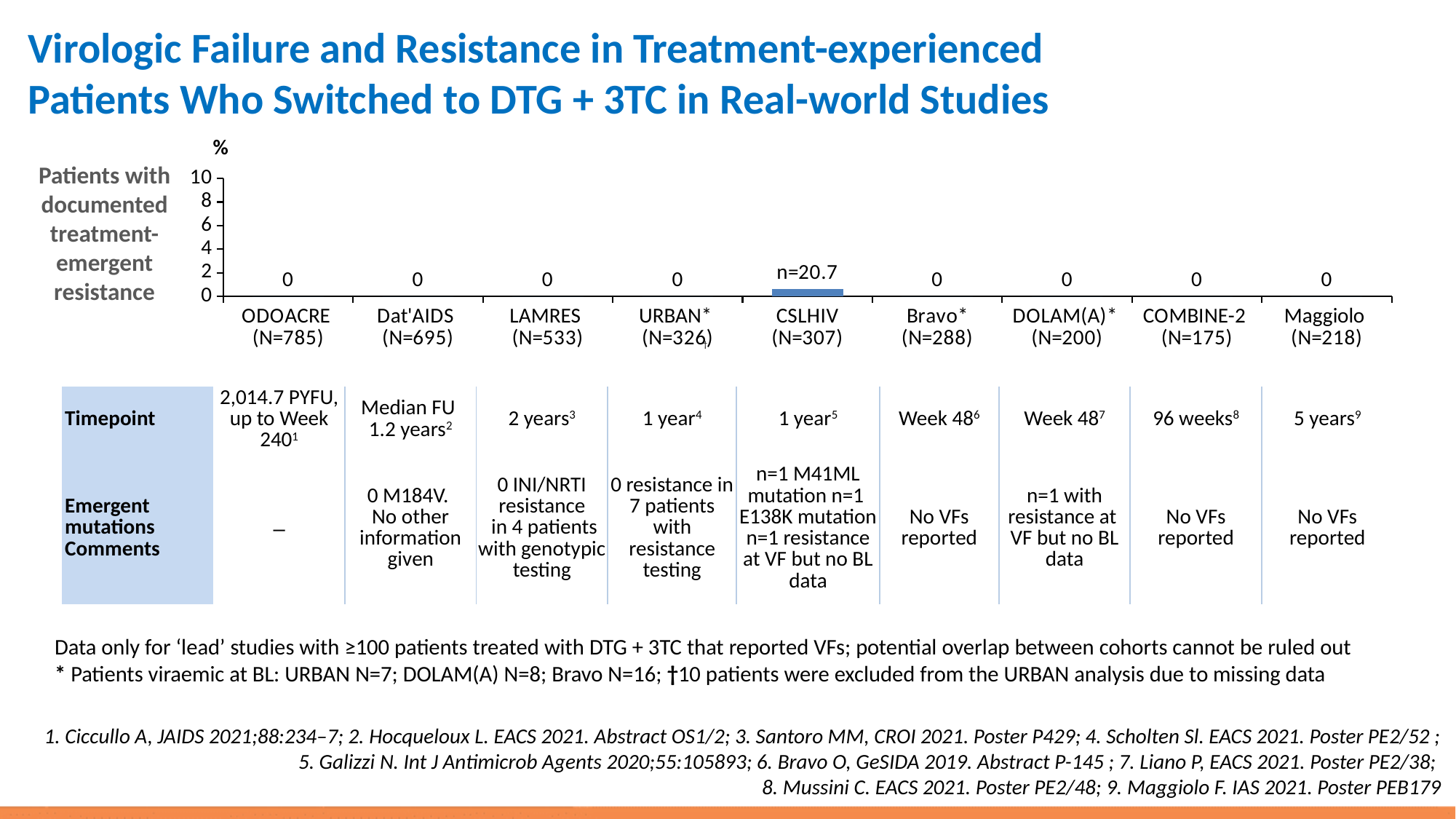
What is the value for Dat'AIDS (N=695) in the chart? 0 What is the value for COMBINE-2 (N=175) in the chart? 0 What is the value for LAMRES (N=533) in the chart? 0 What unit is shown at the top of the y axis? % How many studies are shown on the x axis of the chart? 9 What type of chart is shown on the slide? bar chart Which is larger, the value for CSLHIV or the value for Bravo*? CSLHIV Is the value for CSLHIV greater or less than 4? less What is the value for ODOACRE (N=785) in the chart? 0 Which study is the only one with a visible non-zero bar in the chart? CSLHIV What is the maximum value shown on the y axis of the chart? 10 What is the value for Maggiolo (N=218) in the chart? 0